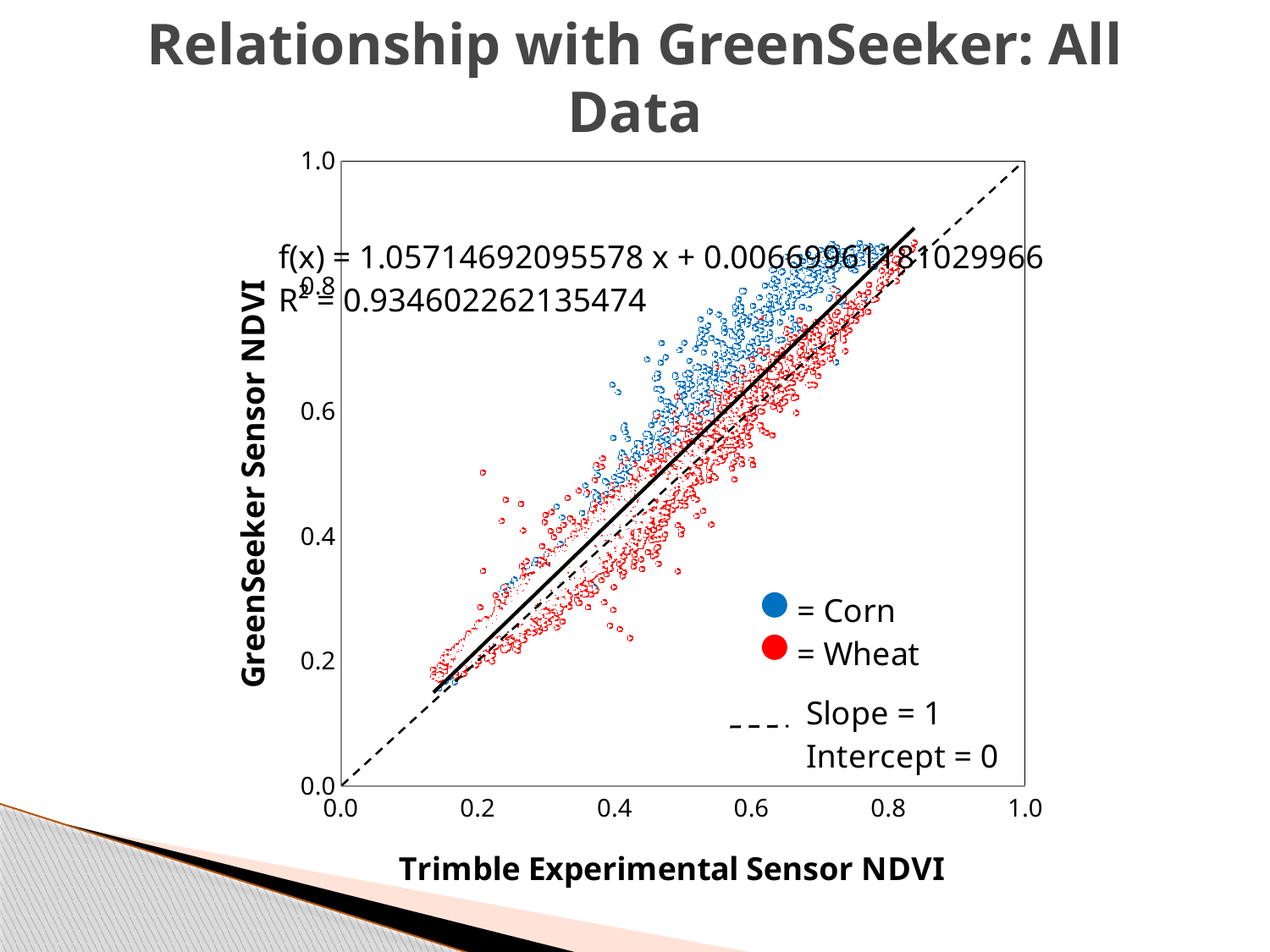
Which has the larger slope, the fitted line f(x) or the dashed reference line? The fitted line f(x) What is the highest tick value shown on the y axis? 1.0 Is the R² value greater or less than 0.9? greater Do the GreenSeeker Sensor NDVI values rise or fall as Trimble Experimental Sensor NDVI increases? Rise What does the dashed line in the legend represent? Slope = 1, Intercept = 0 What is the intercept of the fitted line f(x) printed on the chart? 0.00669961181029966 Is the slope of the fitted line f(x) greater or less than 1? greater What kind of chart is shown on the slide? Scatter chart What is the slope of the fitted line f(x) printed on the chart? 1.05714692095578 How many data series (crop types) does the legend list? 2 What is the title of the x axis? Trimble Experimental Sensor NDVI What is the R² value printed on the chart? 0.934602262135474